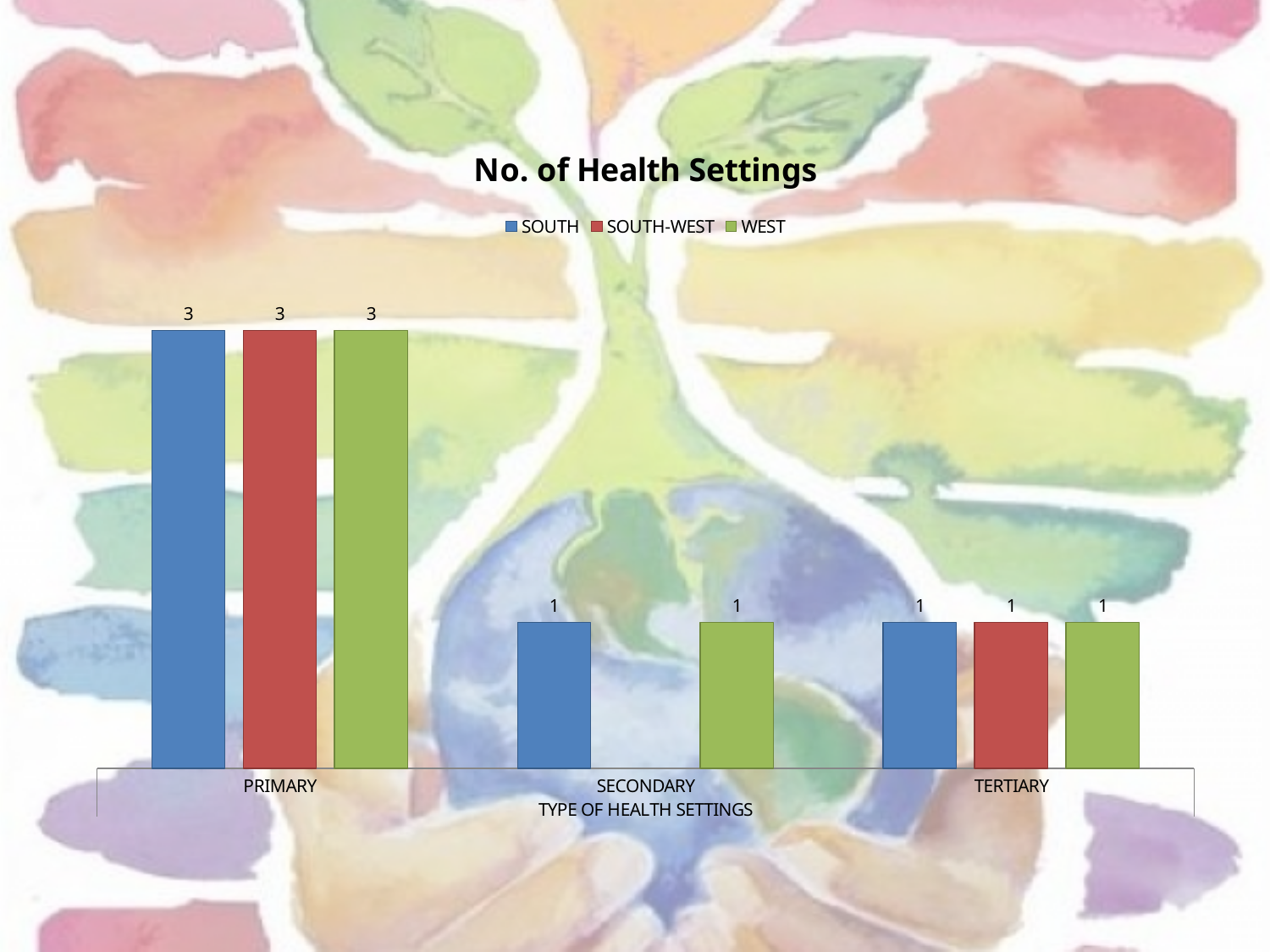
What is the title of the chart? No. of Health Settings What kind of chart is shown on the slide? bar chart Which category has the highest value for the SOUTH series? PRIMARY What is the x-axis title of the chart? TYPE OF HEALTH SETTINGS How many categories are shown on the x axis? 3 What is the value for SOUTH-WEST in the TERTIARY category? 1 What is the difference between the SOUTH value for PRIMARY and the SOUTH value for SECONDARY? 2 Which is larger: the WEST value for PRIMARY or the WEST value for TERTIARY? PRIMARY Do the values for the SOUTH series rise or fall from PRIMARY to TERTIARY? fall How many series does the legend list? 3 What is the value for WEST in the SECONDARY category? 1 What is the value for SOUTH in the PRIMARY category? 3